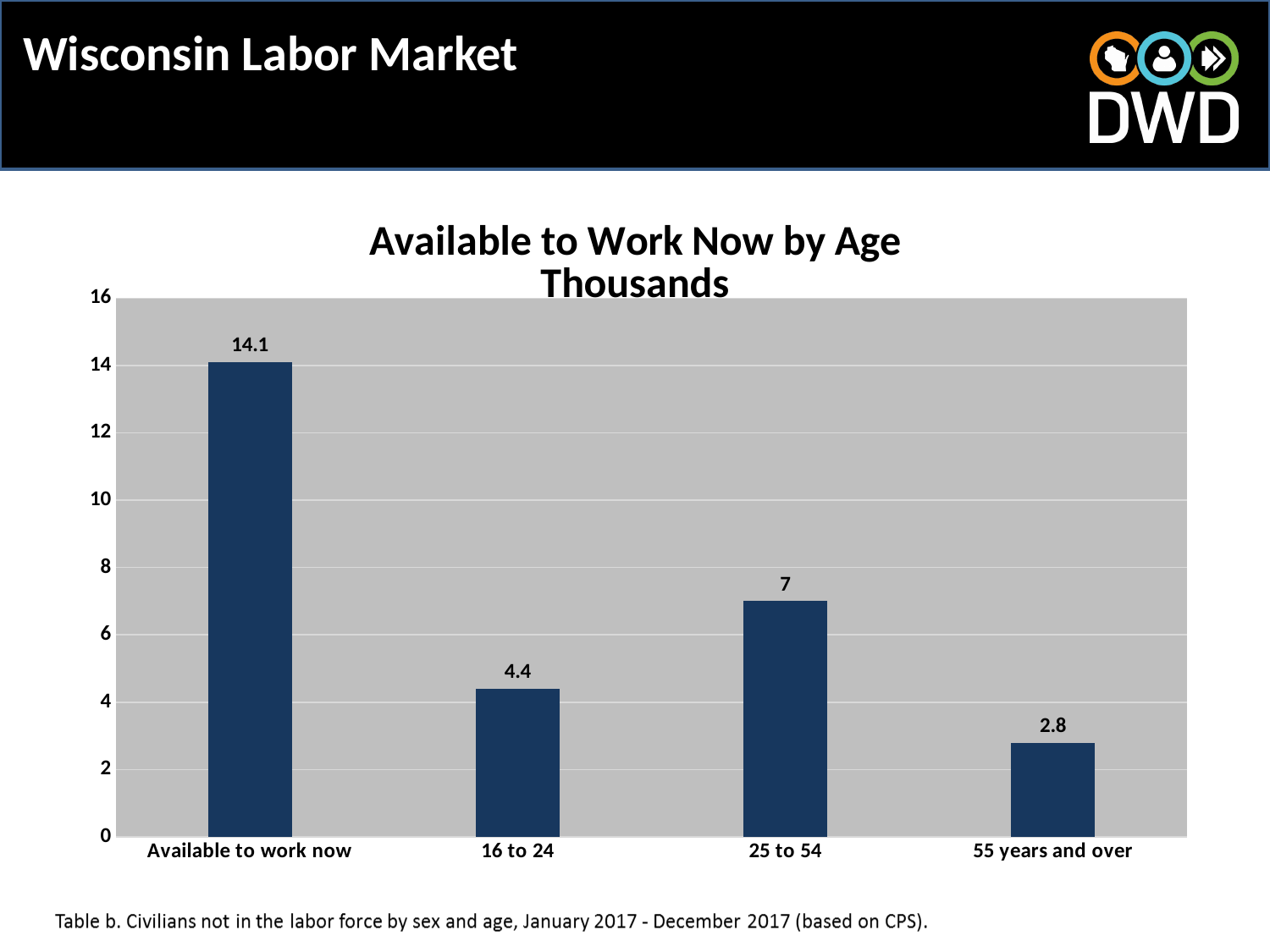
What kind of chart is shown on the slide? Bar chart What is the value for the 16 to 24 age group? 4.4 Which category has the lowest value? 55 years and over What is the difference between the values for 'Available to work now' and '55 years and over'? 11.3 How many bars are shown in the chart? 4 What is the value for the 25 to 54 age group? 7 Which category has the highest value? Available to work now What is the title of the chart? Available to Work Now by Age Thousands Which is larger, the value for 16 to 24 or the value for 25 to 54? 25 to 54 What is the value for 'Available to work now'? 14.1 What is the difference between the values for 25 to 54 and 16 to 24? 2.6 What is the value for '55 years and over'? 2.8